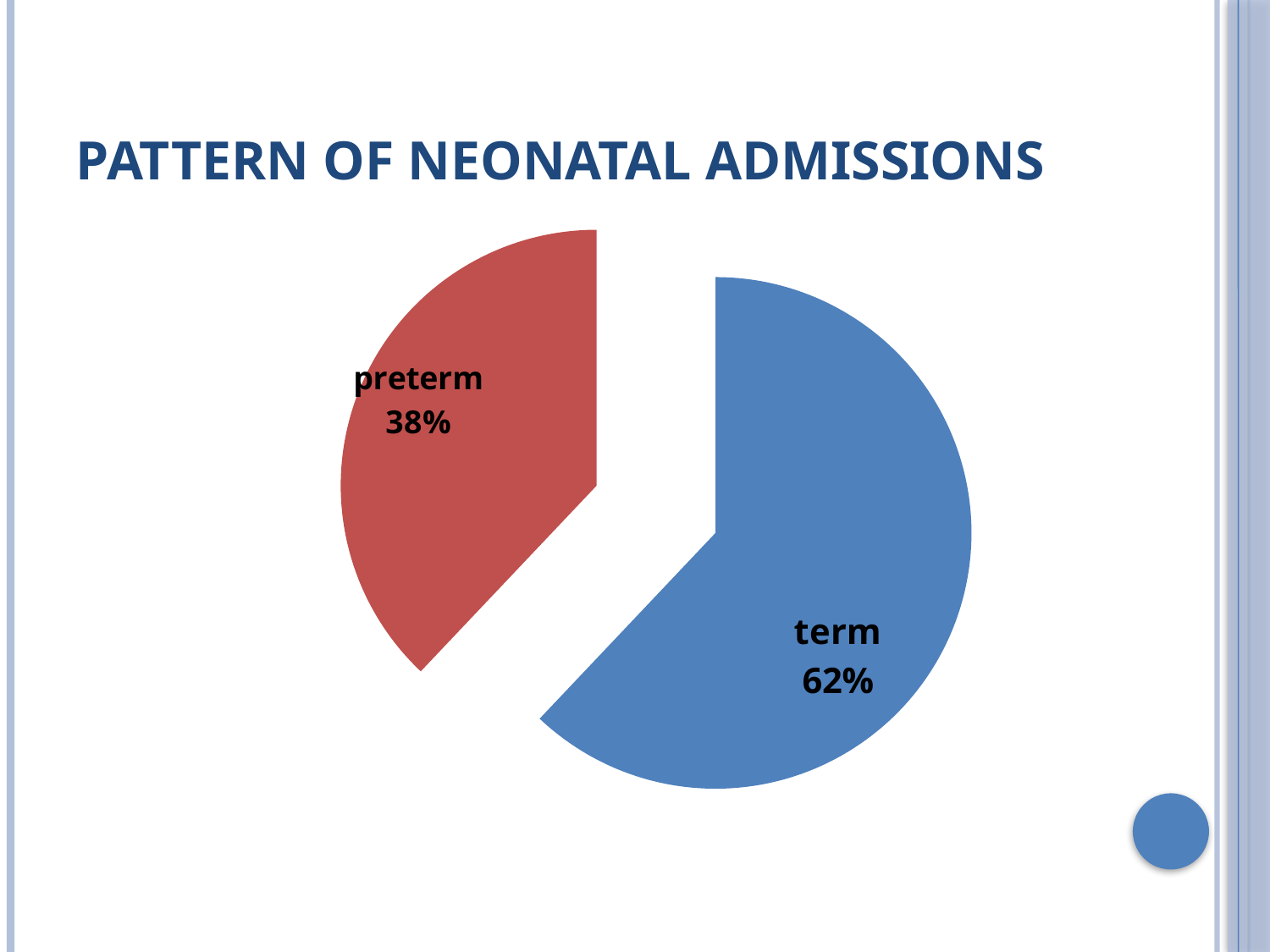
Which category has the smallest slice of the pie? preterm Is the share for preterm admissions greater or less than 50%? less How many slices does the pie chart have? 2 Which category has the largest slice of the pie? term What colour is the term slice of the pie? blue Which is larger, the term slice or the preterm slice? term What kind of chart is shown on the slide? pie chart What share of neonatal admissions is shown for preterm babies? 38% What is the difference in percentage points between the term and preterm slices? 24 percentage points What is the title of the slide? PATTERN OF NEONATAL ADMISSIONS What share of neonatal admissions is shown for term babies? 62%